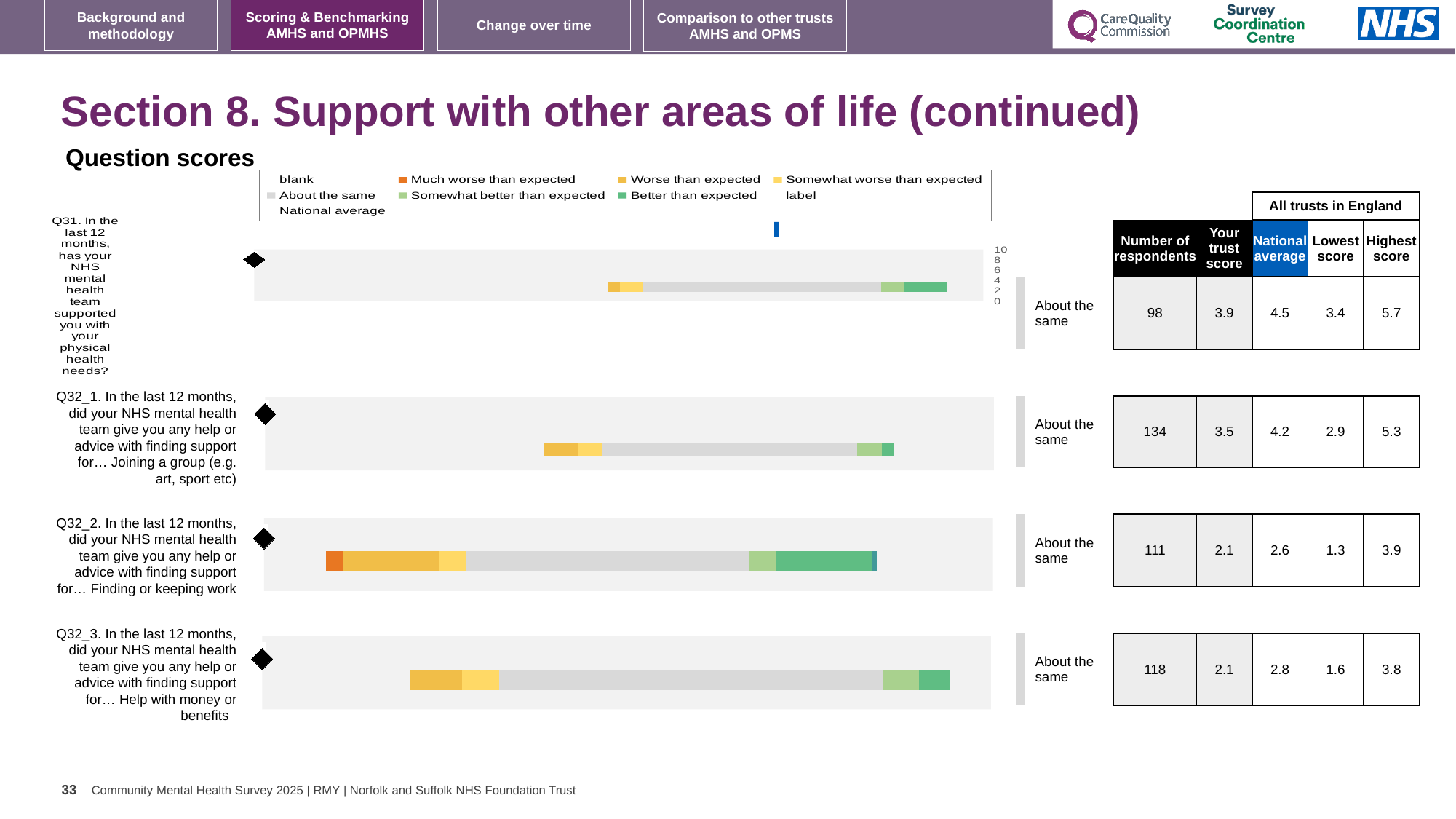
Which question has the highest number of respondents? Q32_1 (Joining a group) Which question has the highest 'Your trust score'? Q31 (physical health needs) For Q31, which is larger: the trust score or the national average? national average What is the difference between the national average and the trust score for Q32_1 (joining a group)? 0.7 What is the 'Your trust score' value for Q31 (support with physical health needs)? 3.9 In the legend, which colour represents 'Much worse than expected'? orange What is the number of respondents for Q32_3 (help with money or benefits)? 118 What is the national average for Q32_1 (help with joining a group)? 4.2 How many questions (bars) are plotted in the question scores charts on this slide? 4 What is the difference between the highest score and the lowest score for Q32_2 (finding or keeping work)? 2.6 How many entries does the legend above the question scores charts list? 9 What kind of chart is used to show the question scores on this slide? bar chart